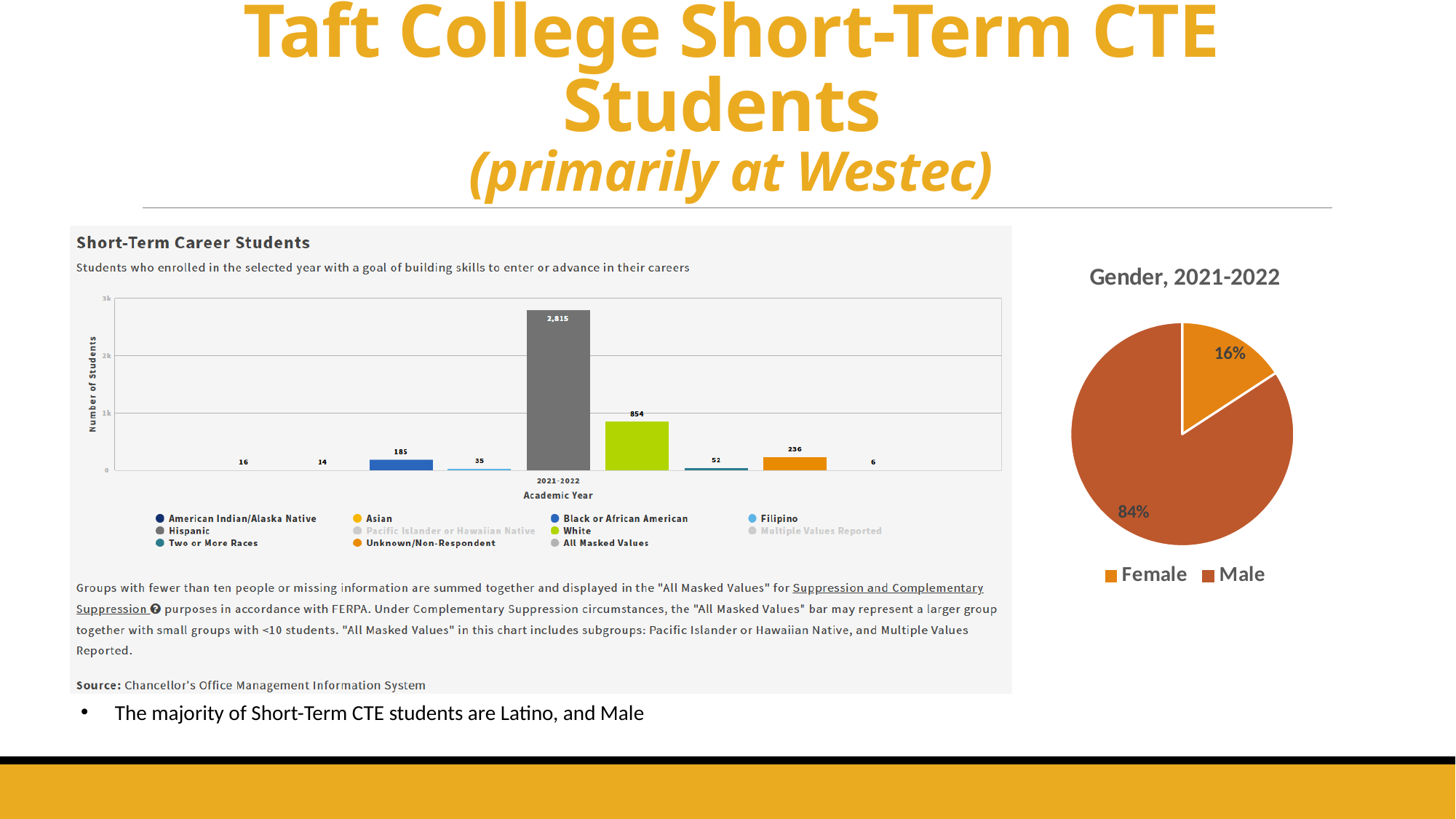
In the Gender, 2021-2022 chart, what share of students are Male? 84% What kind of chart is the Short-Term Career Students chart? Bar chart How many categories does the legend of the Gender, 2021-2022 chart list? 2 In the Short-Term Career Students chart, what is the difference between the Hispanic and White values? 1,961 In the Short-Term Career Students chart, what is the value for Unknown/Non-Respondent? 236 In the Gender, 2021-2022 chart, what share of students are Female? 16% In the Short-Term Career Students chart, what is the value for Black or African American students? 185 In the Short-Term Career Students chart, which is larger: White or Unknown/Non-Respondent? White In the Short-Term Career Students chart, which group has the highest number of students? Hispanic In the Short-Term Career Students chart, what is the value for White students? 854 What kind of chart is the Gender, 2021-2022 chart? Pie chart In the Short-Term Career Students chart, how many Hispanic students are shown? 2,815